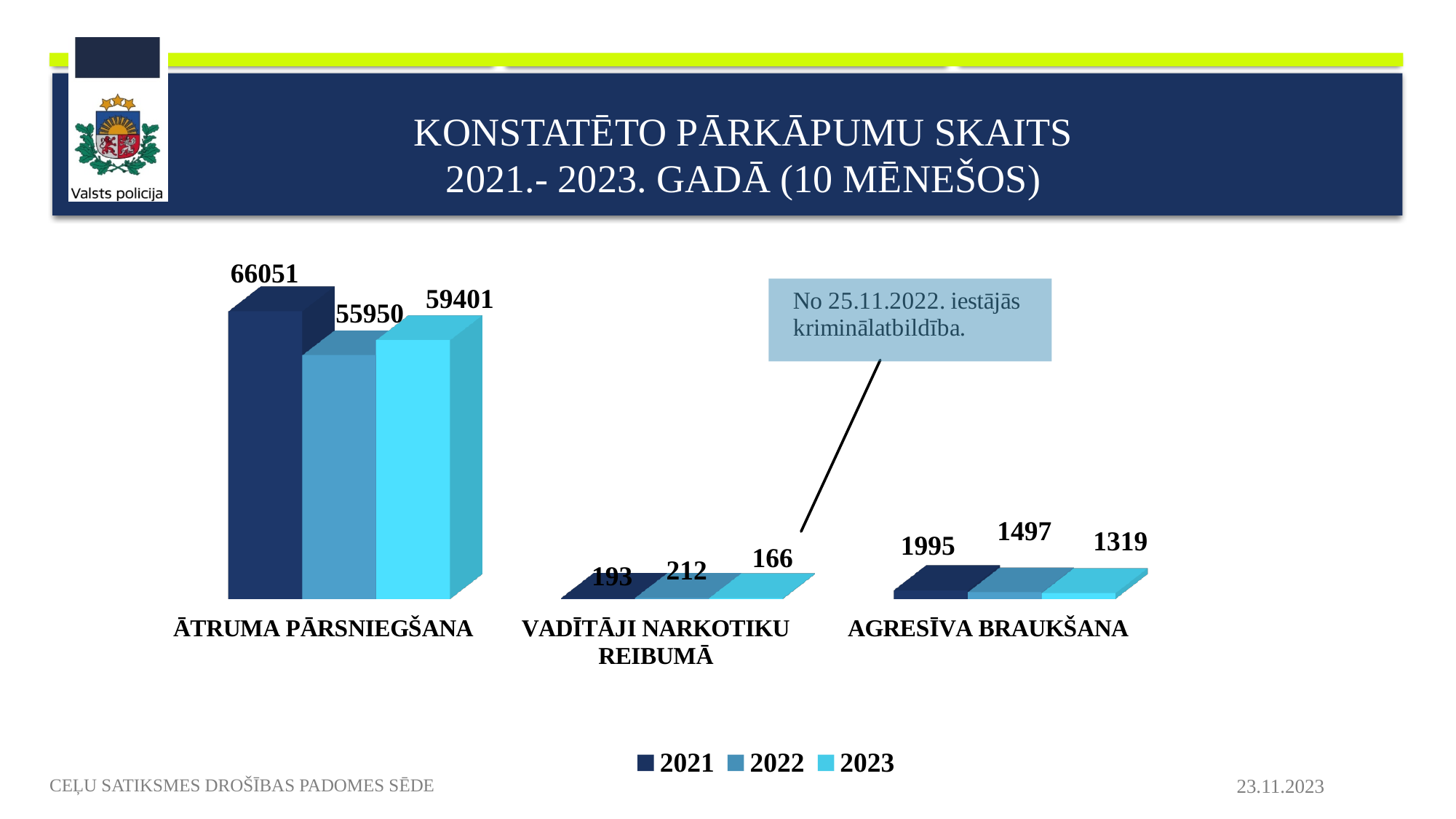
What is the value for 2023 in the AGRESĪVA BRAUKŠANA category? 1319 What is the difference between the 2021 and 2022 values for ĀTRUMA PĀRSNIEGŠANA? 10101 Which year has the highest value in the ĀTRUMA PĀRSNIEGŠANA category? 2021 What is the value for 2022 in the VADĪTĀJI NARKOTIKU REIBUMĀ category? 212 Which year has the lowest value in the VADĪTĀJI NARKOTIKU REIBUMĀ category? 2023 How many series does the legend list? 3 Which is larger for ĀTRUMA PĀRSNIEGŠANA: the 2022 value or the 2023 value? 2023 What is the difference between the 2021 and 2023 values for AGRESĪVA BRAUKŠANA? 676 What is the value for 2021 in the ĀTRUMA PĀRSNIEGŠANA category? 66051 Do the values for AGRESĪVA BRAUKŠANA rise or fall from 2021 to 2023? Fall What kind of chart is shown on the slide? Bar chart How many categories are shown on the x axis of the chart? 3